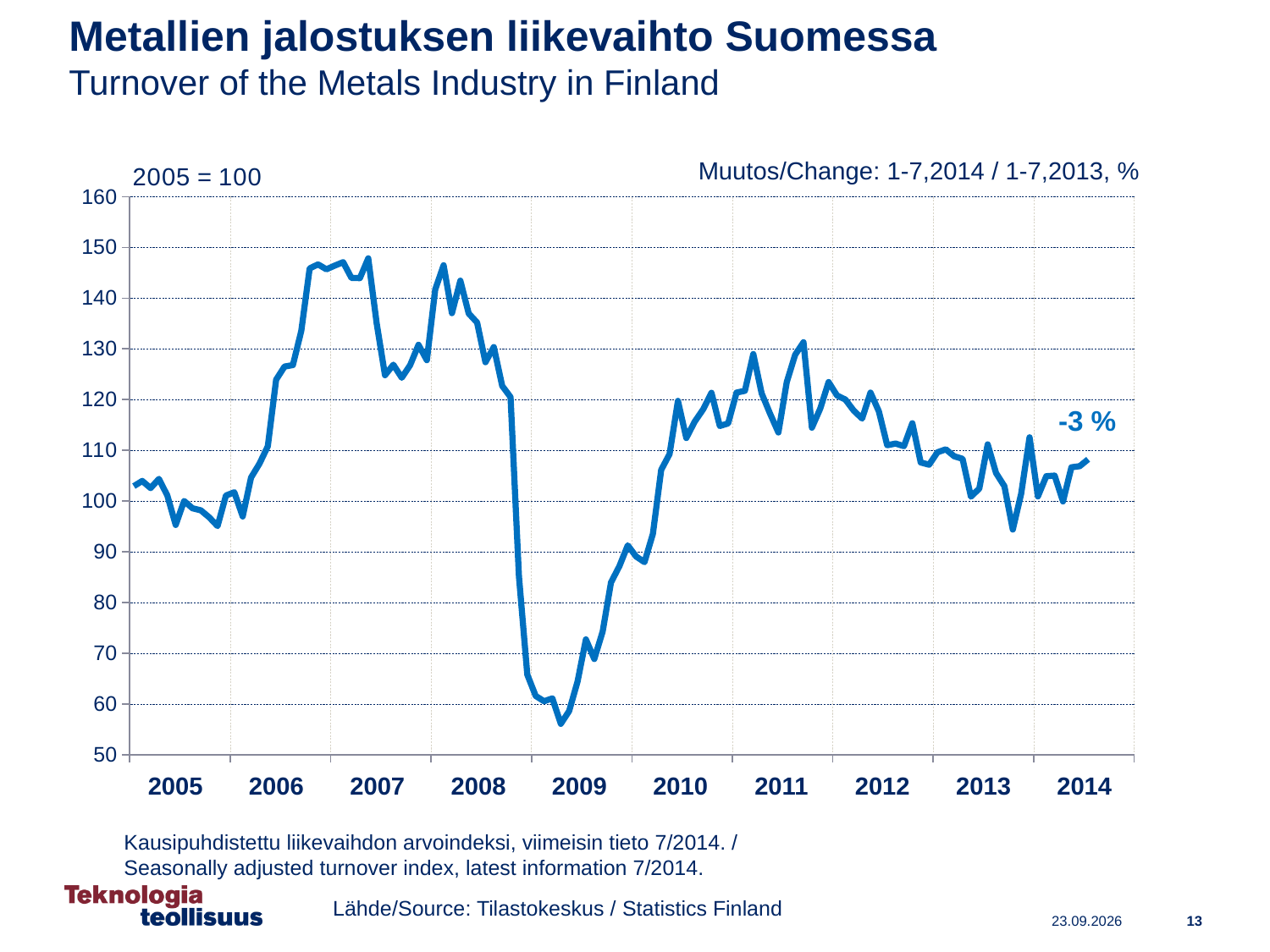
Which is larger: the index value at the start of 2007 or at the start of 2009? 2007 In which year does the turnover index reach its lowest point? 2009 Does the index rise or fall between the start of 2009 and the start of 2010? rise Is the lowest value of the index greater or less than 60? less Is the highest value of the index greater or less than 140? greater Is the value of the index at the start of 2014 greater or less than 120? less Does the index rise or fall between its 2007 peak and the start of 2009? fall What kind of chart is shown on the slide? line chart How many year labels are shown on the x axis? 10 Which year is used as the base year (index = 100) for the turnover index? 2005 What is the percentage change for 1-7,2014 compared with 1-7,2013 shown on the chart? -3 %